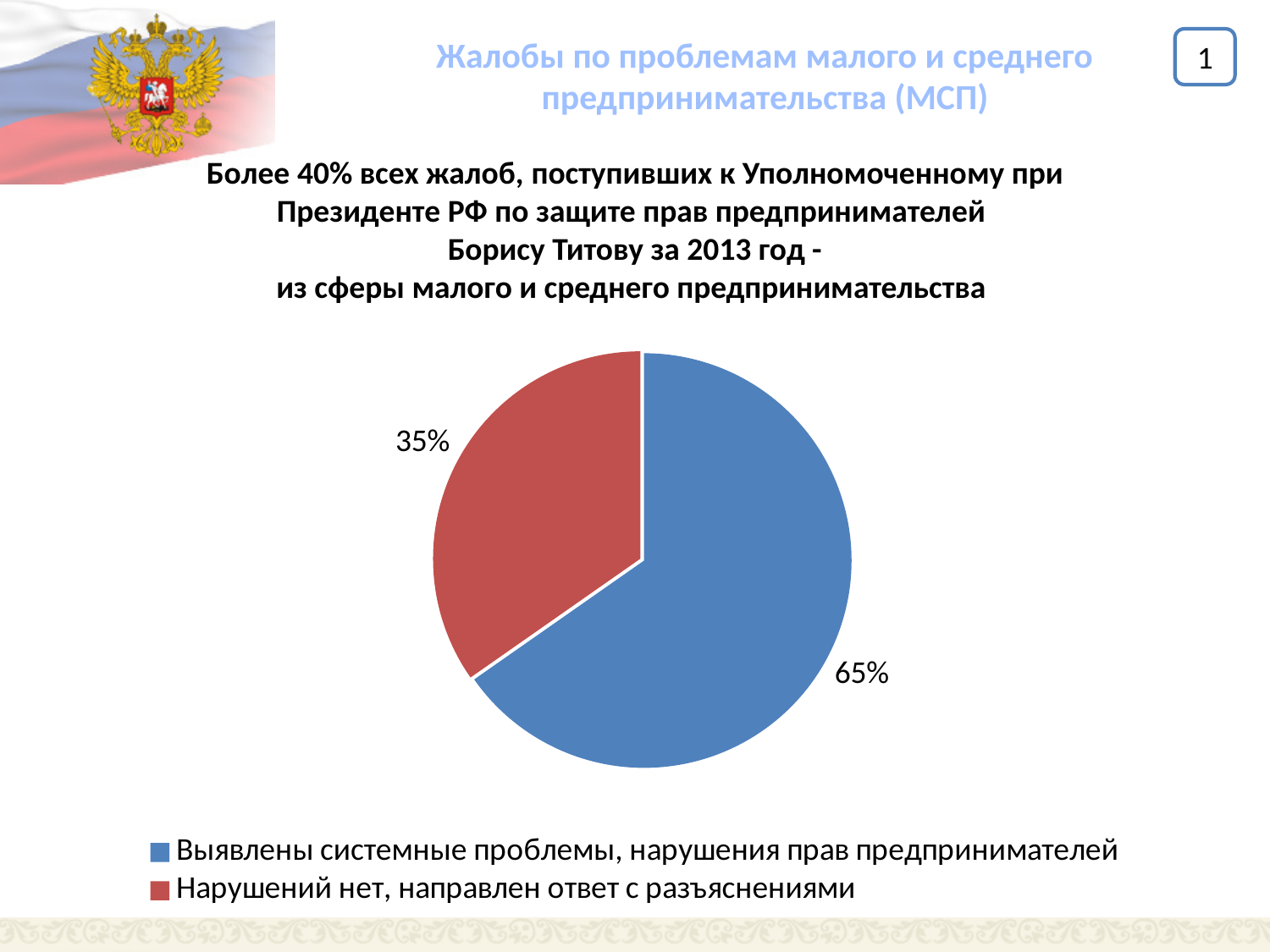
Which category has the largest slice of the pie? Выявлены системные проблемы, нарушения прав предпринимателей What colour is the slice for "Нарушений нет, направлен ответ с разъяснениями"? red How many slices does the pie chart have? 2 What share of the pie is labelled "Выявлены системные проблемы, нарушения прав предпринимателей"? 65% Which category has the smallest slice of the pie? Нарушений нет, направлен ответ с разъяснениями What is the total of the two percentages shown on the pie chart? 100% What colour is the slice for "Выявлены системные проблемы, нарушения прав предпринимателей"? blue What share of the pie is labelled "Нарушений нет, направлен ответ с разъяснениями"? 35% Which is larger: the slice for "Выявлены системные проблемы, нарушения прав предпринимателей" or the slice for "Нарушений нет, направлен ответ с разъяснениями"? Выявлены системные проблемы, нарушения прав предпринимателей What is the difference in percentage points between the two slices of the pie? 30 How many entries does the legend list? 2 What kind of chart is shown on the slide? pie chart